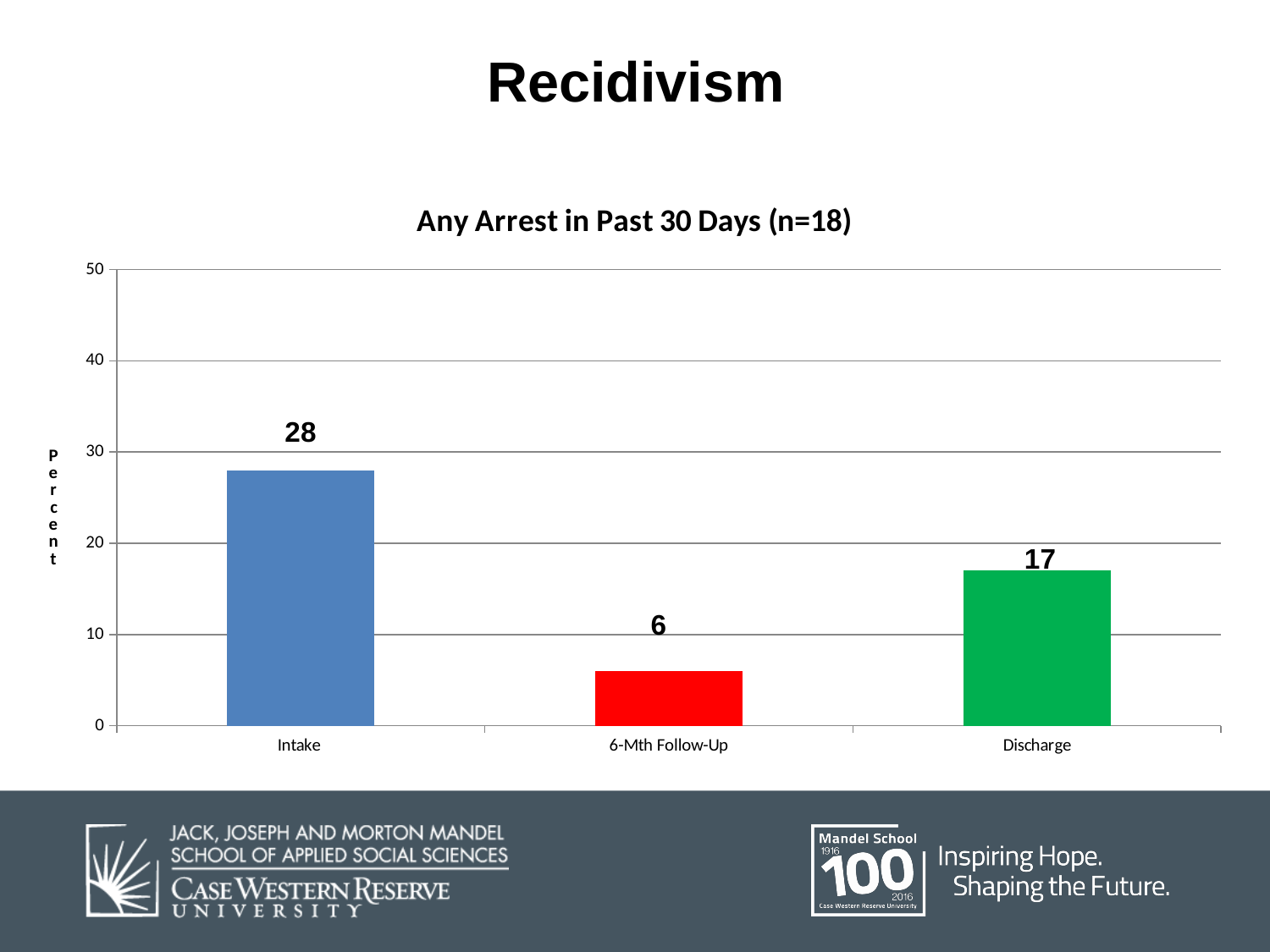
Which category has the lowest value? 6-Mth Follow-Up What is the difference between the values for Intake and Discharge? 11 What is the value for 6-Mth Follow-Up? 6 How many categories are shown on the x axis? 3 Which is larger, the value for Intake or the value for Discharge? Intake What is the difference between the values for Discharge and 6-Mth Follow-Up? 11 Is the value for Intake greater or less than 30? less What is the value for Discharge? 17 What is the title of the chart? Any Arrest in Past 30 Days (n=18) Which category has the highest value? Intake What kind of chart is shown on the slide? bar chart What is the value for Intake? 28